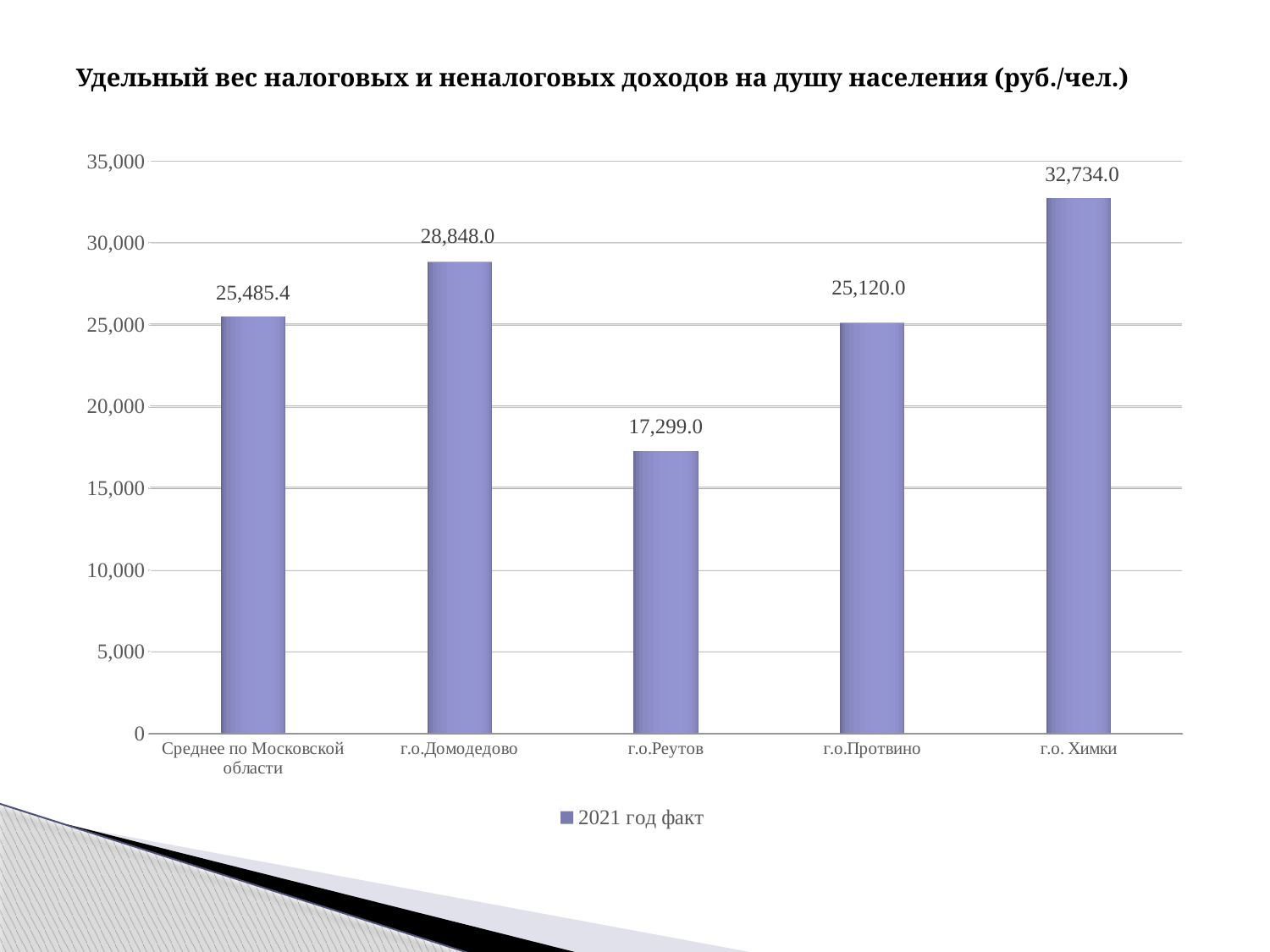
What is the value for Среднее по Московской области? 25,485.4 What is the difference between the values for г.о. Химки and г.о.Реутов? 15,435.0 How many series does the legend list? 1 Is the value for г.о.Реутов greater or less than 20,000? less Which category has the highest value? г.о. Химки Which category has the lowest value? г.о.Реутов How many categories are shown on the chart? 5 What is the value for г.о.Домодедово? 28,848.0 What kind of chart is shown on the slide? bar chart Which is larger, the value for г.о.Домодедово or the value for г.о.Протвино? г.о.Домодедово What is the value for г.о.Реутов? 17,299.0 What is the difference between the values for г.о.Домодедово and г.о.Протвино? 3,728.0